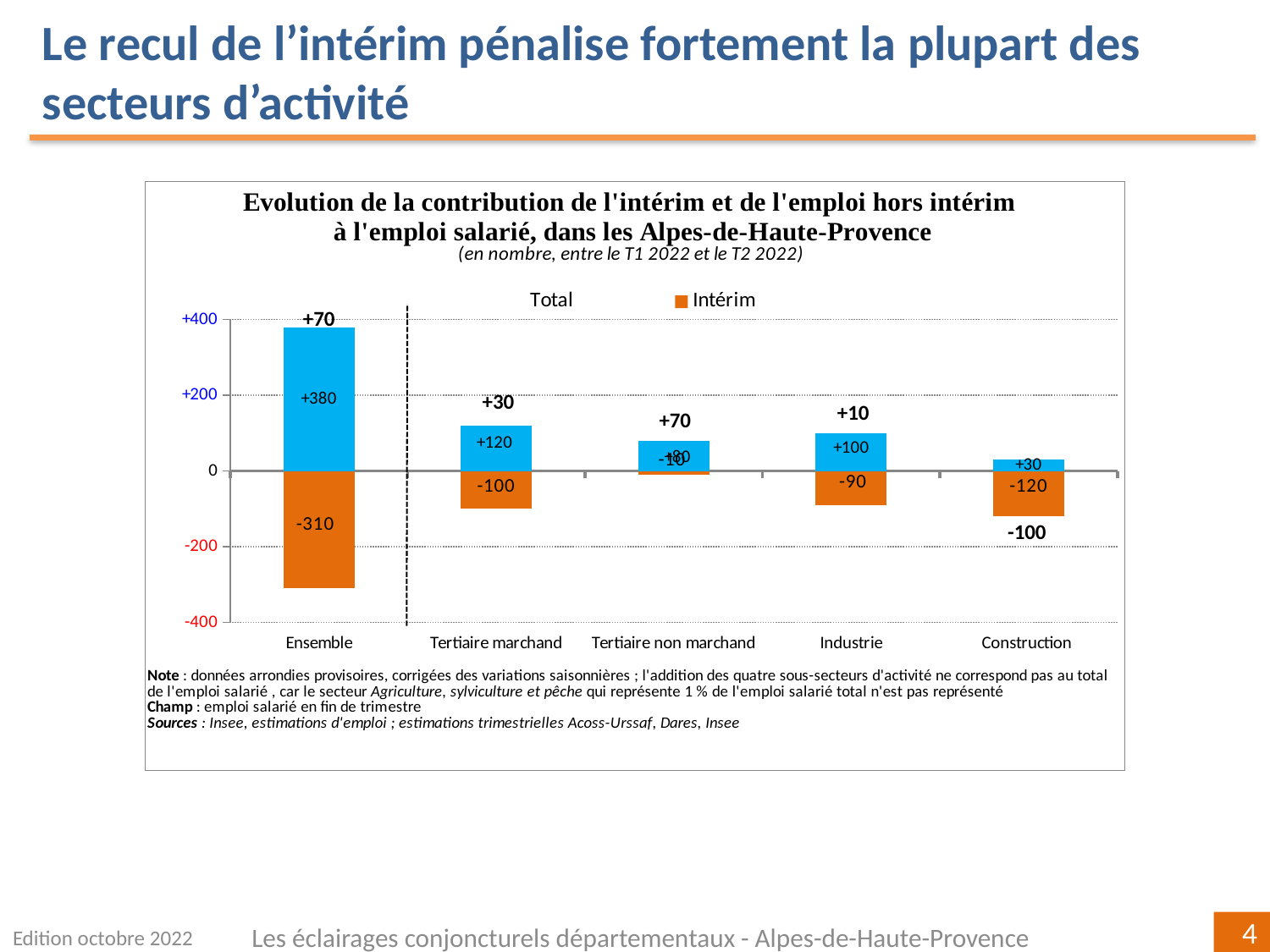
What is the value of the blue (non-Intérim) bar for Industrie? +100 Which has a larger Intérim decline, Ensemble or Industrie? Ensemble Which category has the largest blue (non-Intérim) bar? Ensemble What is the difference between the blue bar for Ensemble (+380) and the blue bar for Tertiaire marchand (+120)? 260 What is the Intérim value for Ensemble? -310 How many categories are shown on the x axis? 5 Which sector has the lowest total value? Construction What kind of chart is shown on the slide? Bar chart What is the total shown for Construction? -100 Is the blue bar for Ensemble greater or less than +200? greater What is the total shown above the bars for Tertiaire marchand? +30 What is the Intérim value for Construction? -120